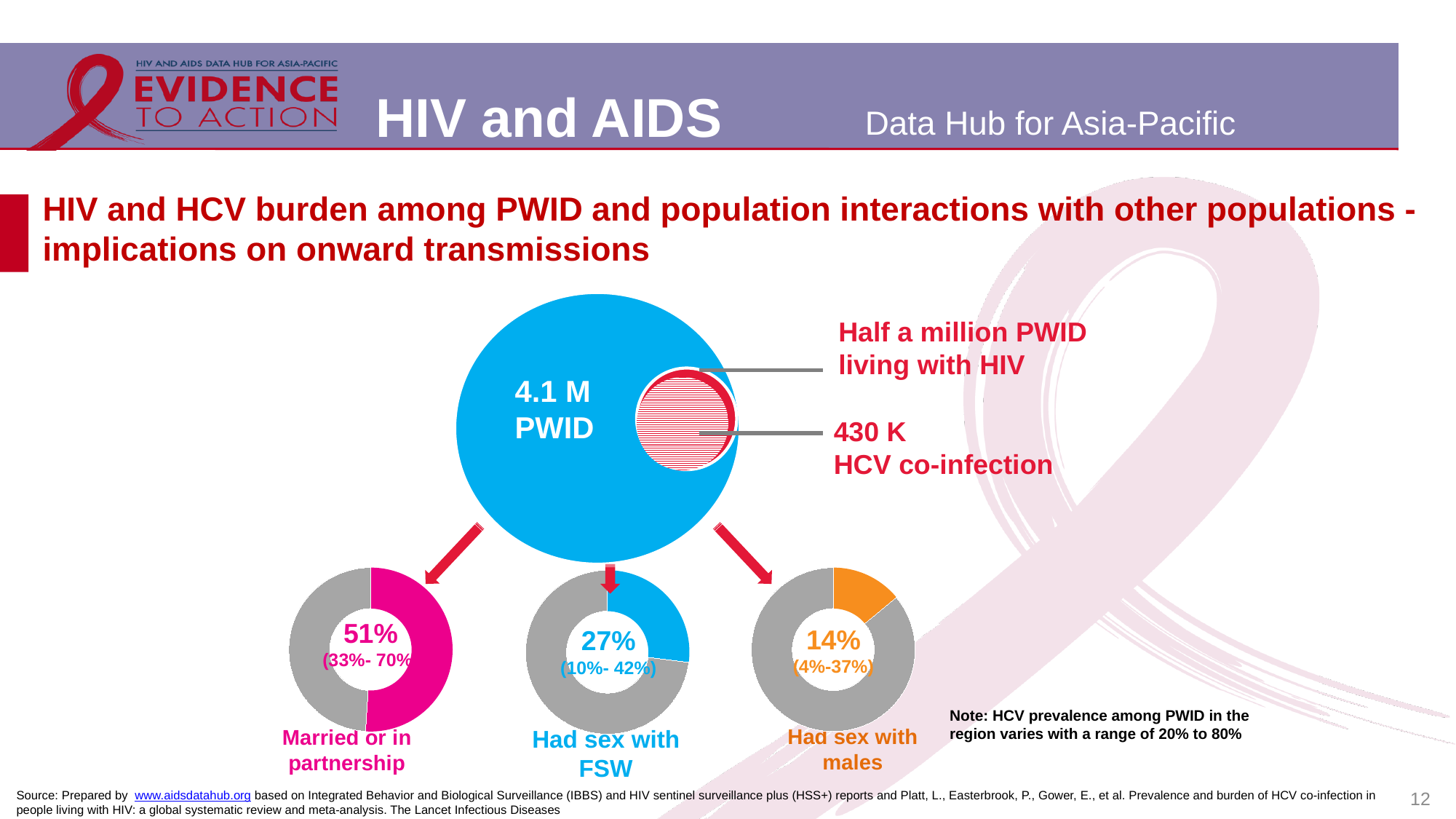
In the 'Had sex with males' donut chart, what percentage is shown? 14% What is the difference in percentage points between the 'Married or in partnership' value and the 'Had sex with FSW' value? 24 percentage points Among the three donut charts, which category has the highest percentage? Married or in partnership How many donut charts are shown at the bottom of the slide? 3 In the 'Married or in partnership' donut chart, what percentage is shown? 51% Which is larger: the 'Had sex with FSW' percentage or the 'Had sex with males' percentage? Had sex with FSW Among the three donut charts, which category has the lowest percentage? Had sex with males In the 'Had sex with FSW' donut chart, what percentage is shown? 27% What colour is the highlighted slice in the 'Had sex with males' donut chart? Orange What range is printed below the 51% value in the 'Married or in partnership' donut chart? (33%- 70%) What kind of chart is used to show the 51%, 27% and 14% values? Donut (pie) chart What range is printed below the 14% value in the 'Had sex with males' donut chart? (4%-37%)